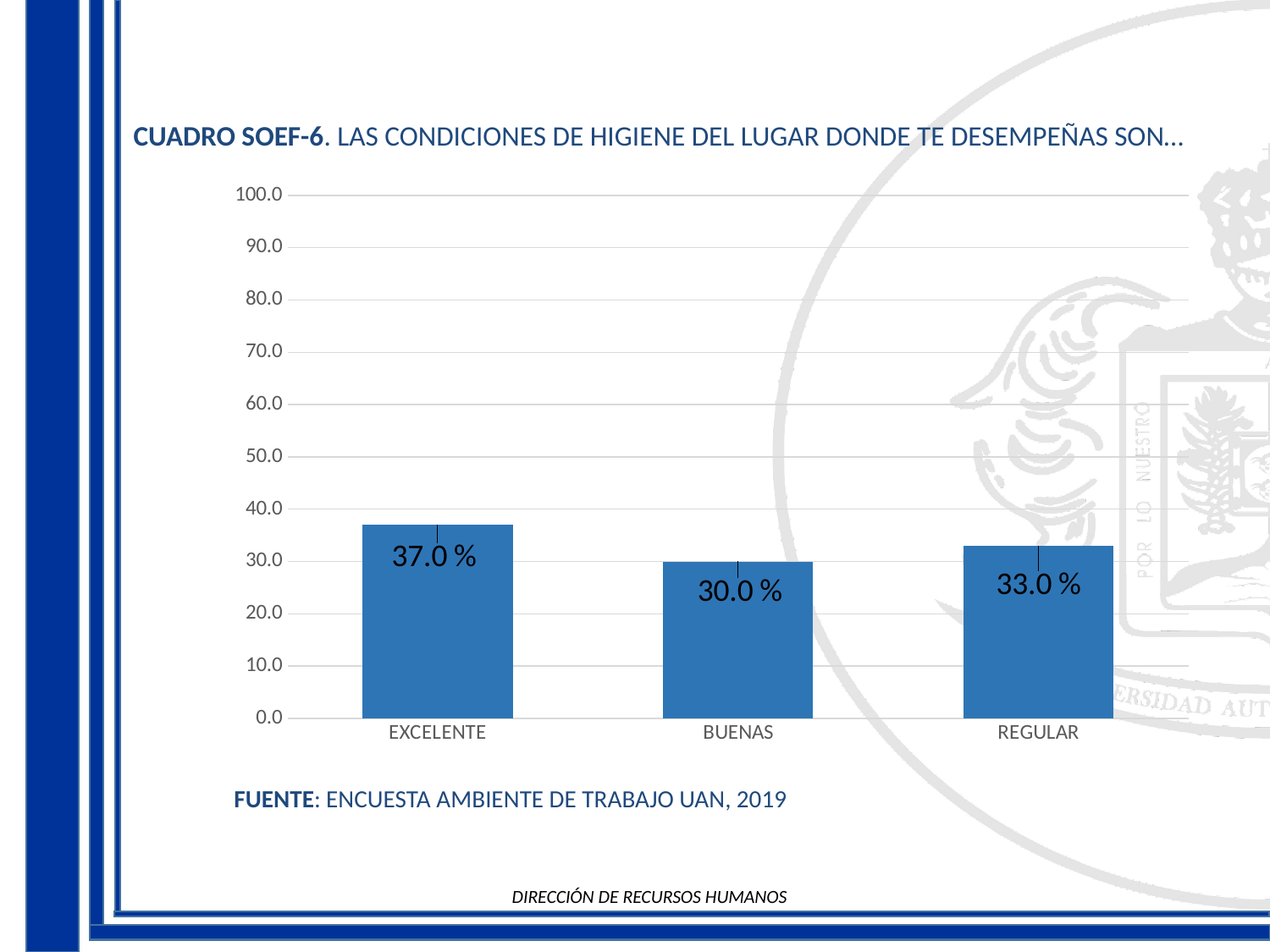
What is the difference between the values for REGULAR and BUENAS? 3.0 % What is the value for REGULAR? 33.0 % Which category has the highest value? EXCELENTE How many categories are shown on the x axis? 3 Which category has the lowest value? BUENAS What is the value for BUENAS? 30.0 % What is the difference between the values for EXCELENTE and BUENAS? 7.0 % What is the value for EXCELENTE? 37.0 % Which is larger, the value for REGULAR or the value for BUENAS? REGULAR What source is cited below the chart? ENCUESTA AMBIENTE DE TRABAJO UAN, 2019 Is the value for EXCELENTE greater or less than 40.0? less What kind of chart is shown on the slide? bar chart